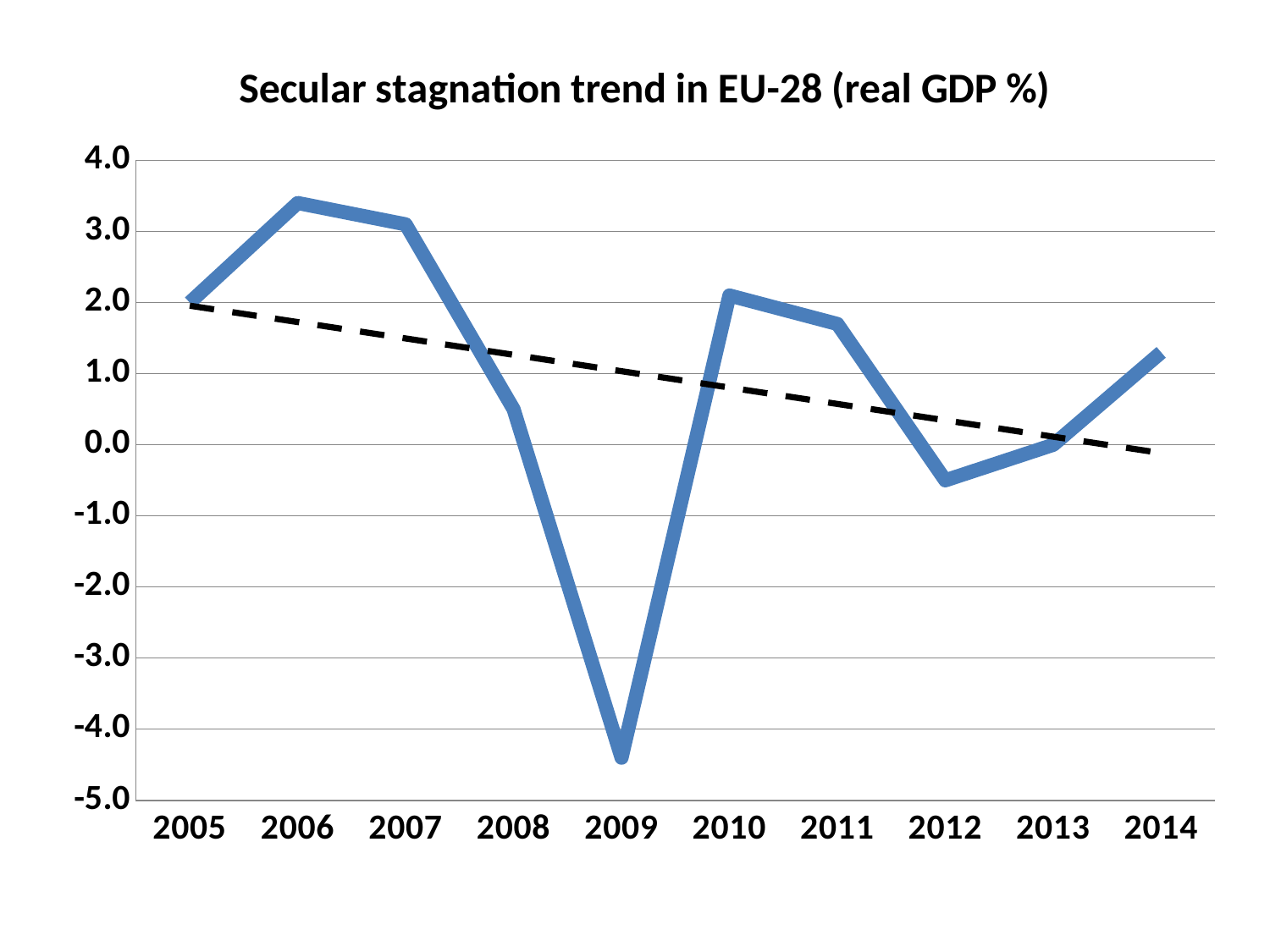
Does the dashed trend line rise or fall from 2005 to 2014? fall Is the value for 2012 greater or less than 0.0? less How many years are plotted along the x axis? 10 Is the value for 2014 greater or less than 1.0? greater In which year is real GDP growth highest? 2006 Is the value for 2009 greater or less than -4.0? less What kind of chart is shown on the slide? line chart Which year has the higher value, 2010 or 2011? 2010 What is the title of the chart? Secular stagnation trend in EU-28 (real GDP %) In which year is real GDP growth lowest? 2009